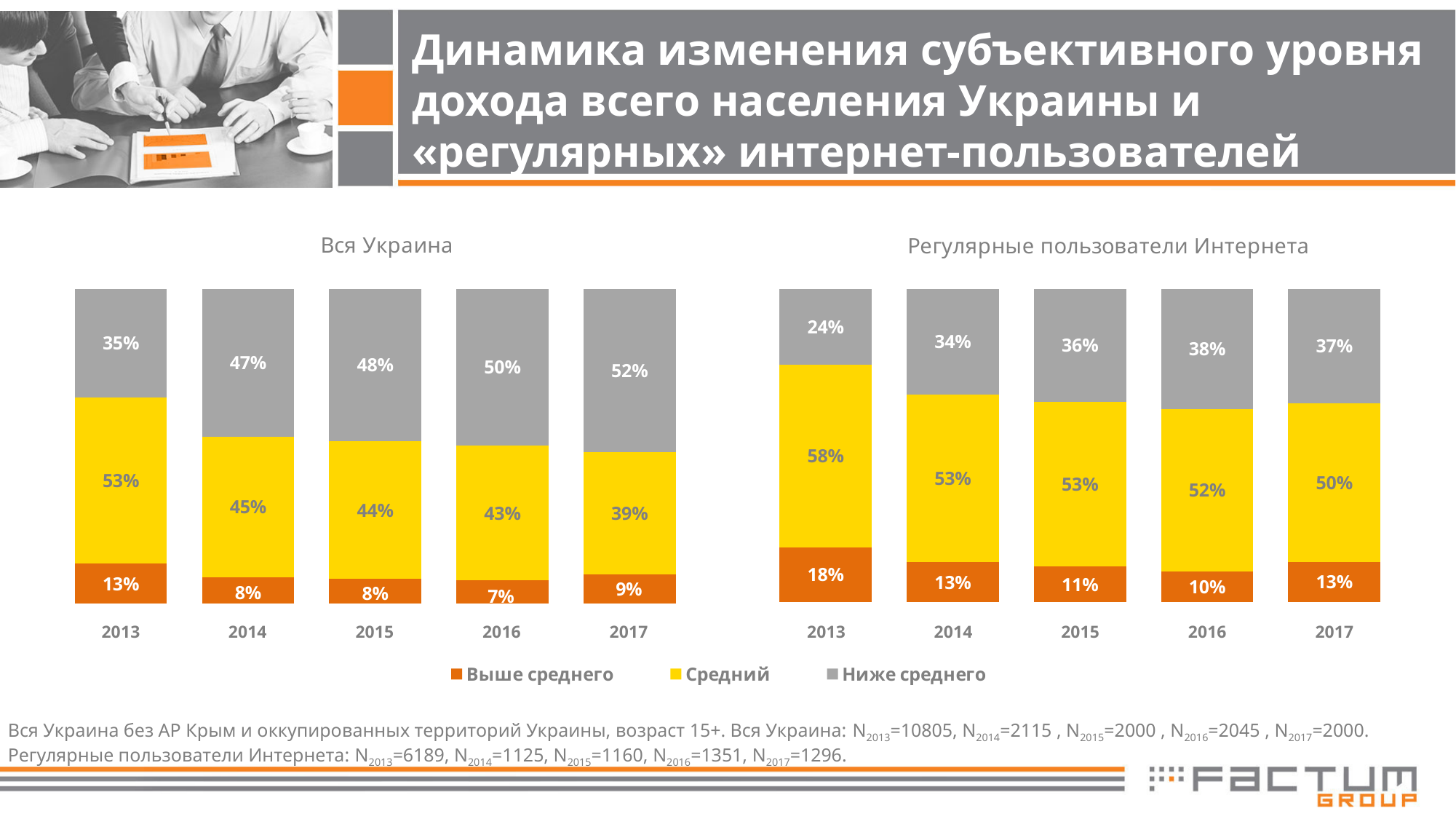
In the "Вся Украина" chart, what is the value of "Ниже среднего" for 2017? 52% In the "Регулярные пользователи Интернета" chart, which year has the highest value for "Ниже среднего"? 2016 In the "Регулярные пользователи Интернета" chart, is the "Выше среднего" value for 2013 larger or smaller than the value for 2017? larger What type of chart is used for "Регулярные пользователи Интернета"? Stacked bar chart Which colour represents "Средний" in the legend? Yellow In the "Регулярные пользователи Интернета" chart, what is the total of the three segments for 2014? 100% In the "Вся Украина" chart, does the "Ниже среднего" value rise or fall from 2013 to 2017? rise In the "Вся Украина" chart, which year has the lowest value for "Выше среднего"? 2016 How many years are shown on the x axis of the "Вся Украина" chart? 5 In the "Регулярные пользователи Интернета" chart, what is the value of "Средний" for 2013? 58% In the "Вся Украина" chart, what is the difference between the "Средний" values for 2013 and 2017? 14% How many series does the legend list? 3